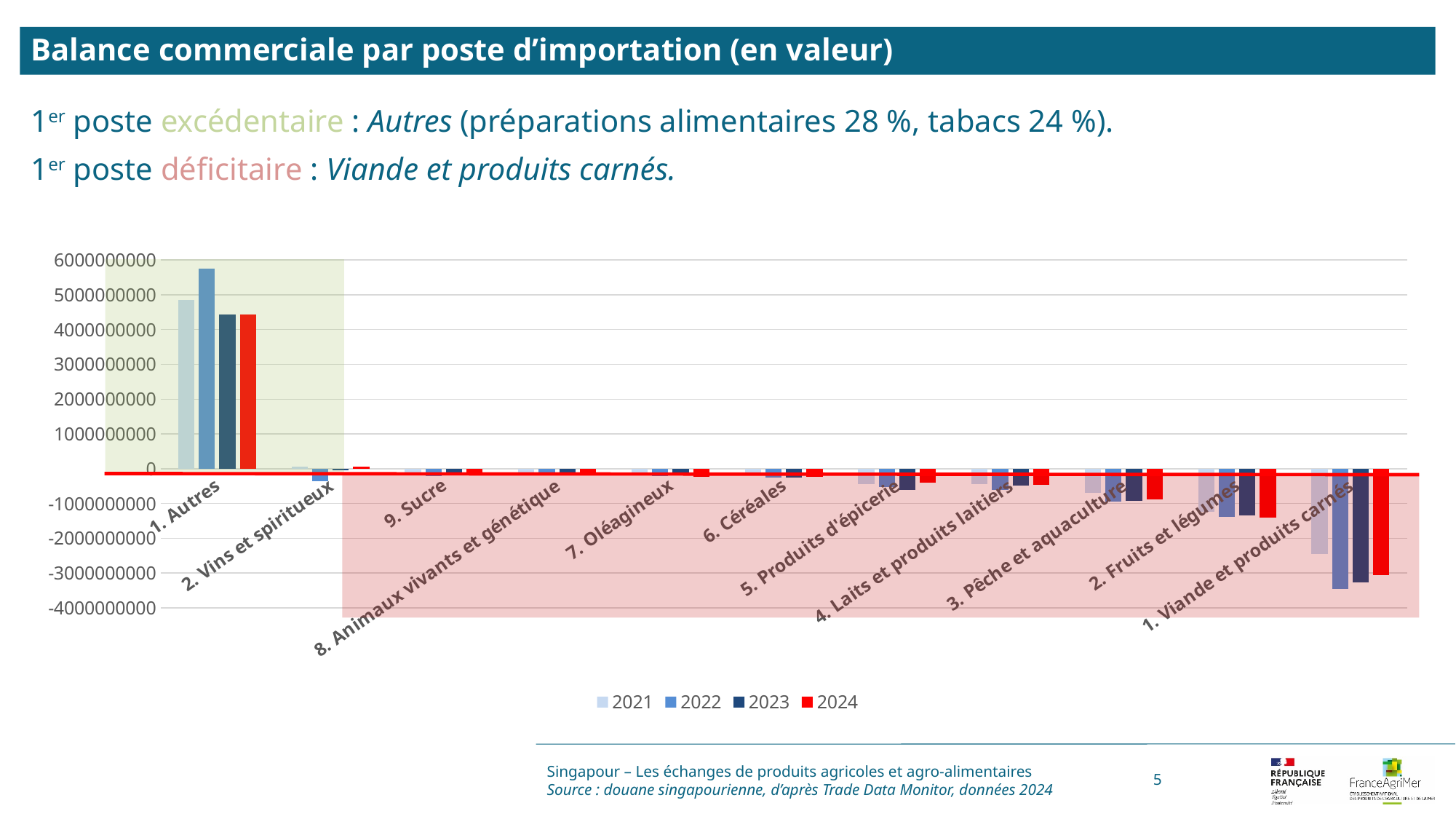
Is the 2022 value for 1. Viande et produits carnés greater or less than -3000000000? less Is the 2024 value for 1. Autres greater or less than 4000000000? greater Is the 2022 value for 1. Autres greater or less than 5000000000? greater Which category has the highest value in the chart? 1. Autres Which category has the lowest (most negative) value in the chart? 1. Viande et produits carnés Do the values generally rise or fall moving from left to right along the x axis? fall How many series does the legend list? 4 How many categories are shown on the x axis of the chart? 11 Which colour represents the 2024 series in the legend? red What kind of chart is shown on the slide? bar chart For 1. Autres, which is larger: the 2022 value or the 2024 value? 2022